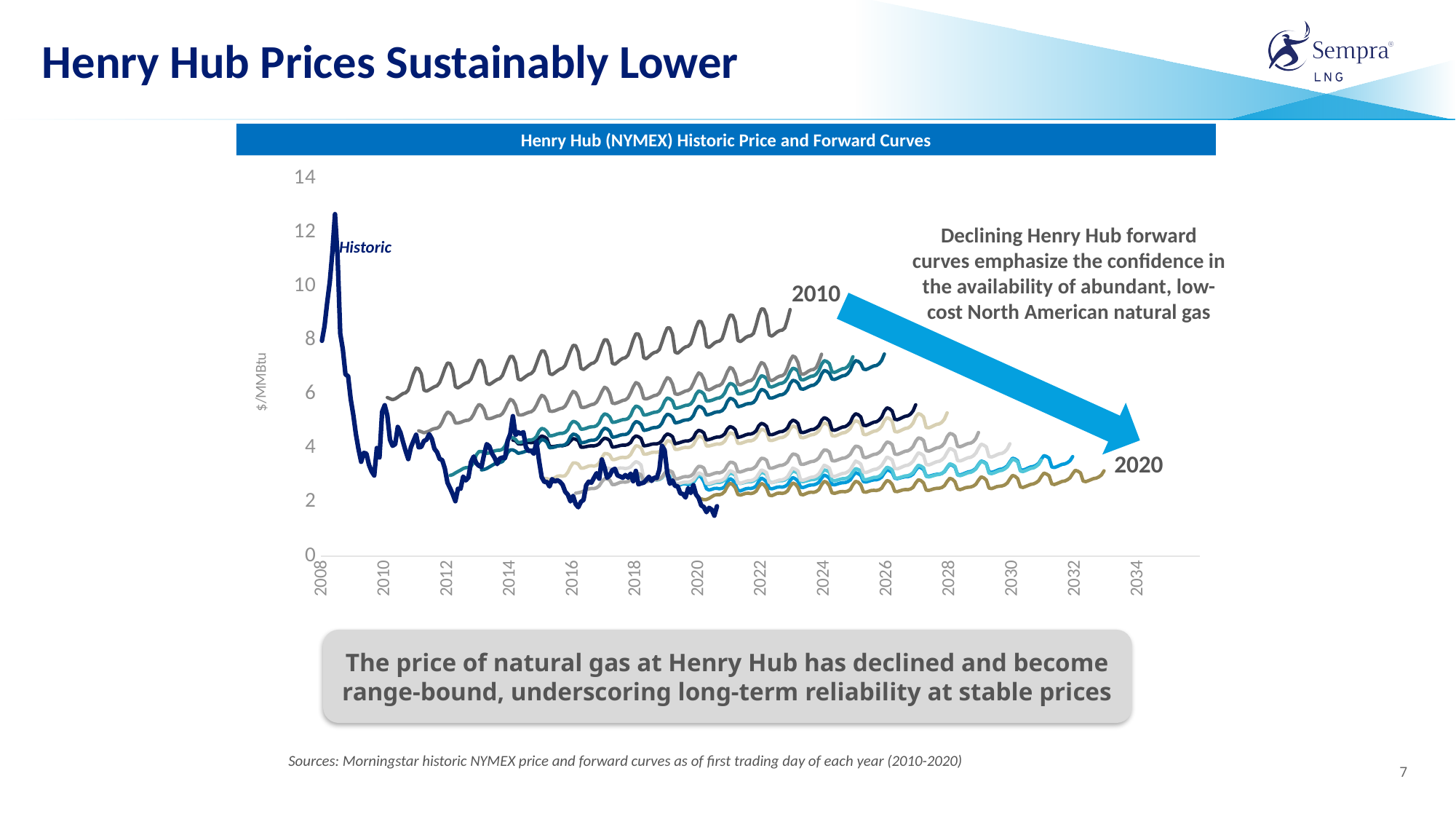
Which forward curve is the lowest on the chart, the 2010 curve or the 2020 curve? 2020 What is the highest value shown on the vertical axis? 14 What is the title of the chart? Henry Hub (NYMEX) Historic Price and Forward Curves Is the 2010 forward curve higher or lower than the 2020 forward curve? Higher Which forward curve is the highest on the chart, the 2010 curve or the 2020 curve? 2010 What unit is shown on the chart's vertical axis? $/MMBtu Is the end value of the 2010 forward curve greater or less than 8 $/MMBtu? greater How many year labels are shown on the horizontal axis? 14 Is the peak of the Historic line greater or less than 10 $/MMBtu? greater Is the end value of the 2020 forward curve greater or less than 4 $/MMBtu? less What kind of chart is shown on the slide? Line chart Does the 2010 forward curve rise or fall along the x axis? Rise